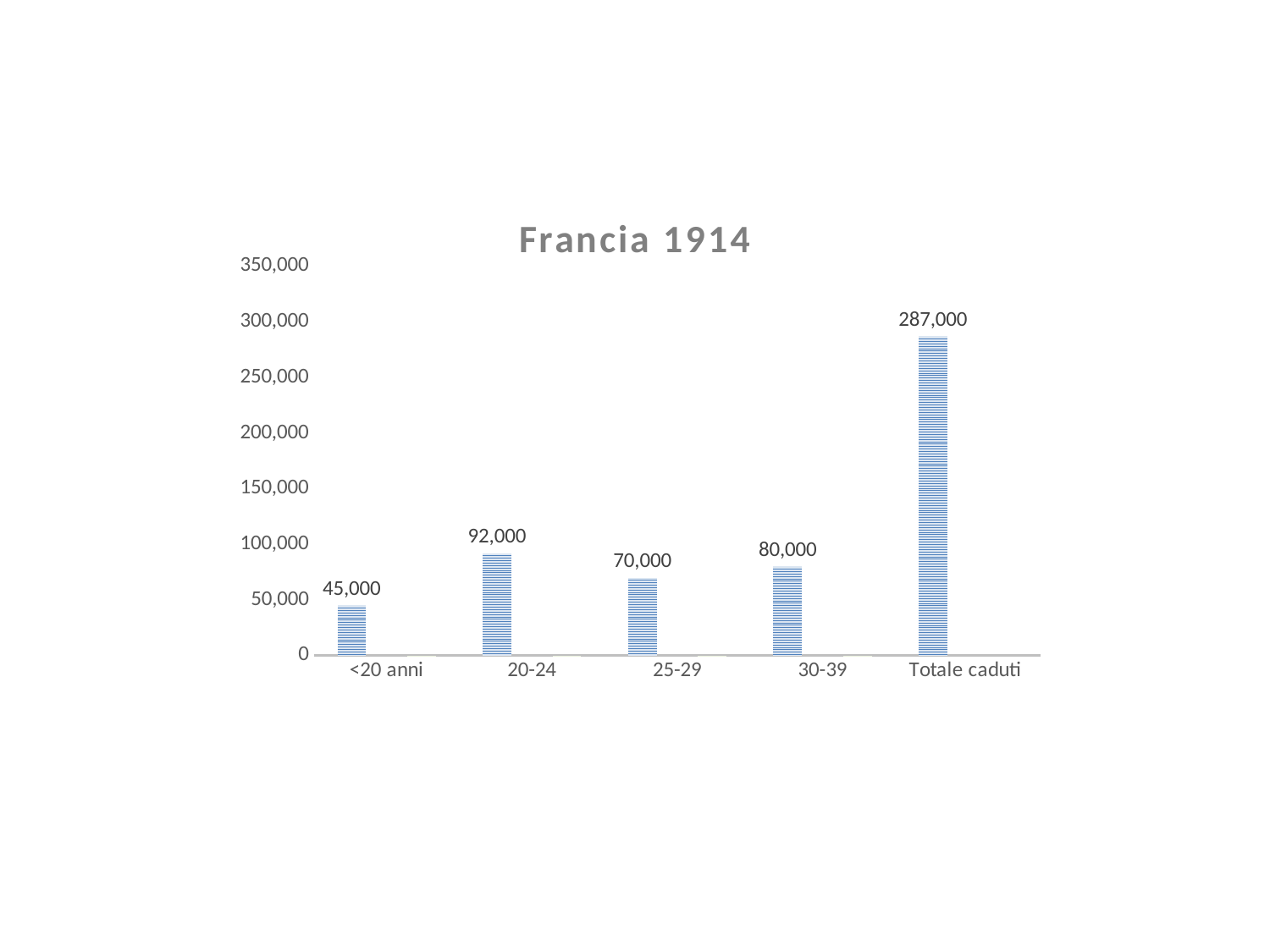
Which category has the lowest value? <20 anni Which category has the highest value? Totale caduti What is the value for Totale caduti? 287,000 What is the value for the 20-24 category? 92,000 How many categories are shown on the x axis? 5 What is the difference between the values for 20-24 and 25-29? 22,000 Is the value for 20-24 greater or less than 100,000? less What is the title of the chart? Francia 1914 What is the difference between the values for 30-39 and <20 anni? 35,000 Among the age groups (excluding Totale caduti), which has the highest value? 20-24 What is the value for the <20 anni category? 45,000 Which is larger, the value for 25-29 or the value for 30-39? 30-39